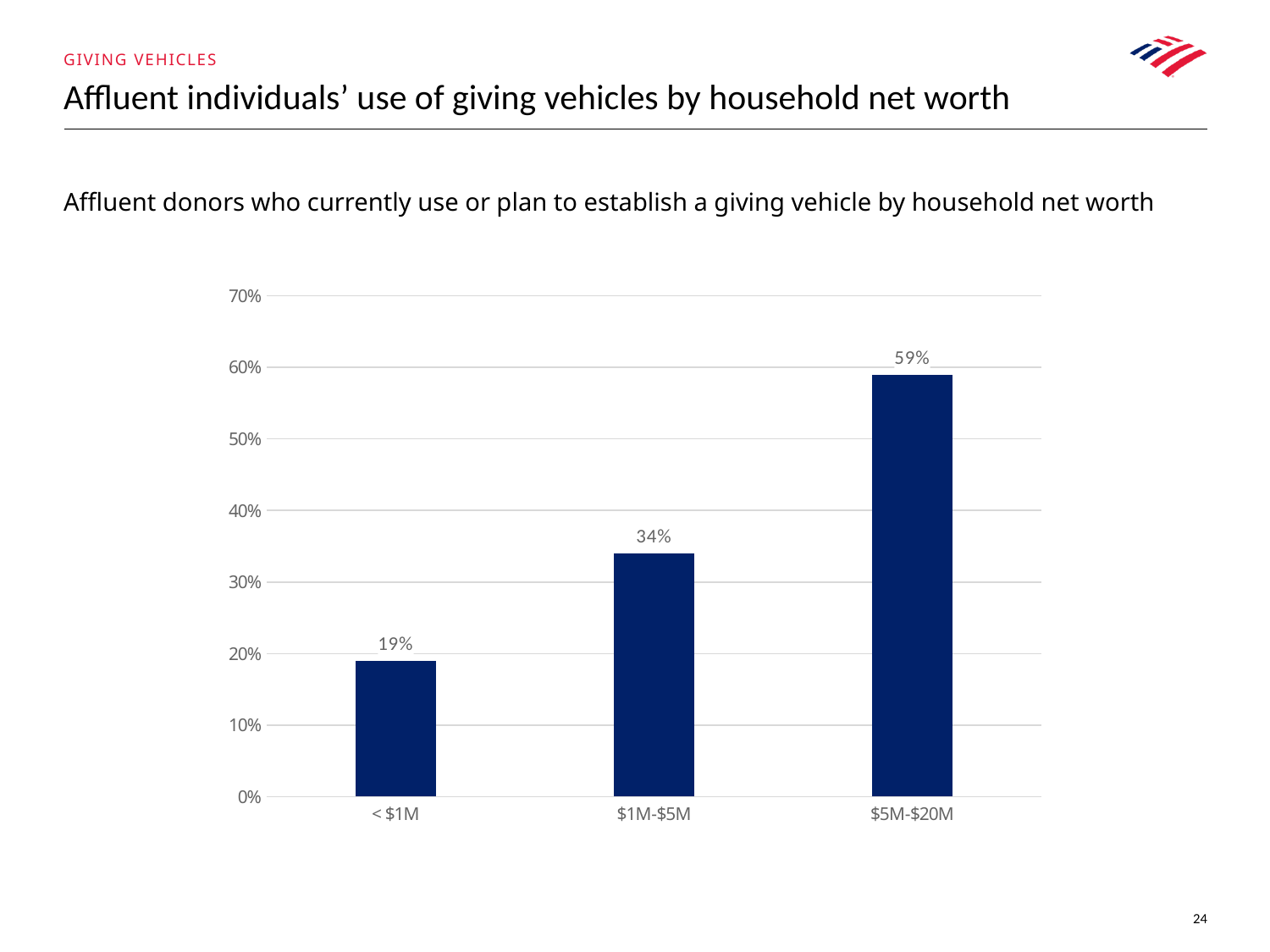
What kind of chart is shown on the slide? Bar chart What is the difference in percentage points between the $5M-$20M and the < $1M categories? 40 percentage points Is the value for the $1M-$5M category greater or less than 30%? greater What is the value shown for the $5M-$20M household net worth category? 59% What is the difference in percentage points between the $1M-$5M and the < $1M categories? 15 percentage points Do the values rise or fall as household net worth increases along the x axis? Rise How many household net worth categories are shown on the chart? 3 Which household net worth category has the lowest value on the chart? < $1M What is the value shown for the $1M-$5M household net worth category? 34% What percentage of affluent donors with household net worth under $1M currently use or plan to establish a giving vehicle? 19% Which is larger: the value for $1M-$5M or the value for $5M-$20M? $5M-$20M Which household net worth category has the highest share of donors using or planning to establish a giving vehicle? $5M-$20M